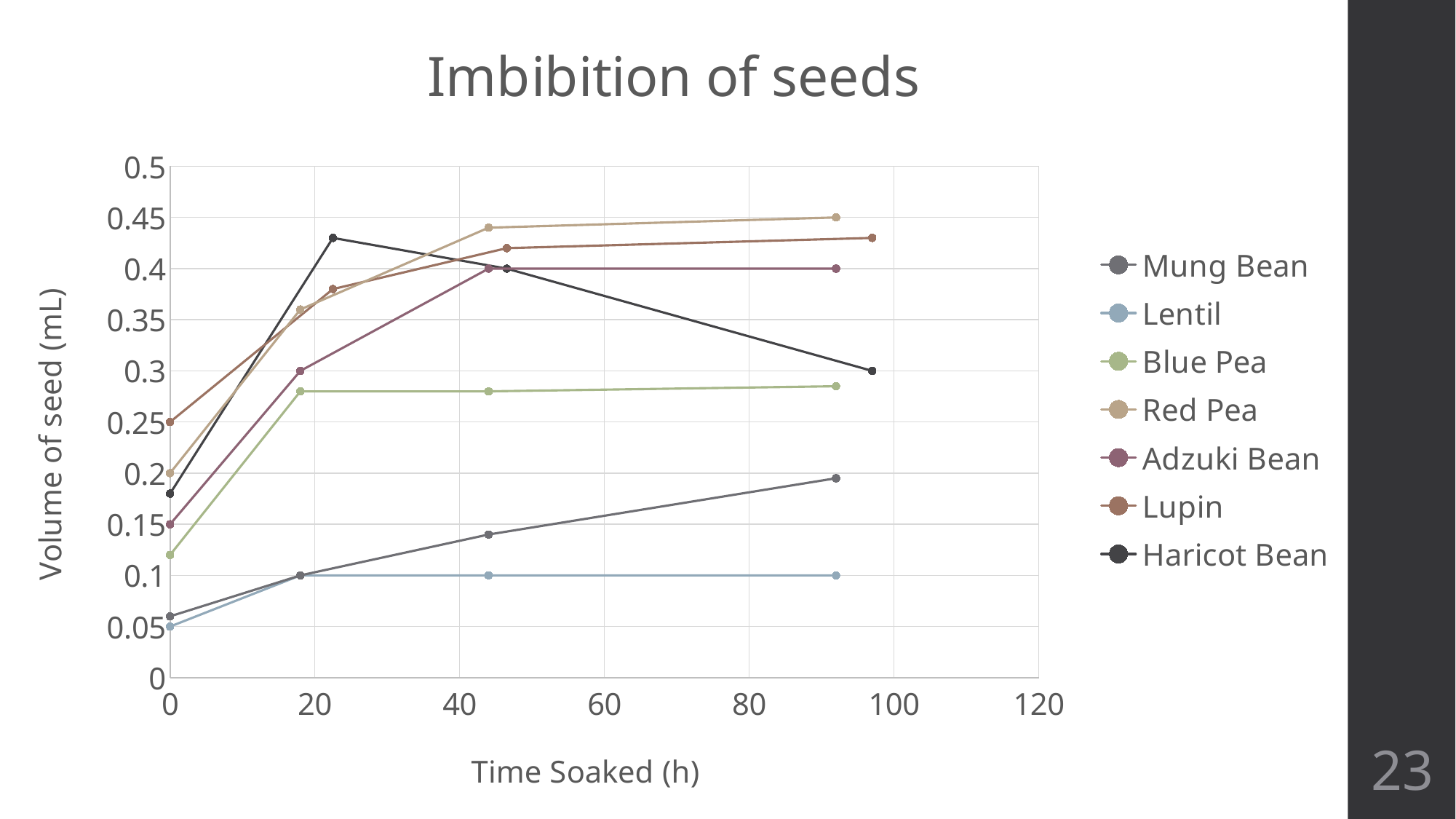
Does the Mung Bean series rise or fall along the x axis? rises At the final time point, which is larger: Red Pea or Blue Pea? Red Pea What is the volume of the Lupin seed at 0 h? 0.25 How many data points are plotted for each series? 4 How many series does the legend list? 7 What is the label on the vertical axis? Volume of seed (mL) Is the final value for Blue Pea greater or less than 0.25? greater What is the volume of the Red Pea seed at 0 h? 0.2 What kind of chart is shown on the slide? line chart What is the title of the chart? Imbibition of seeds What is the volume of the Lentil seed at 0 h? 0.05 Which series has the lowest volume at the end of the soaking period? Lentil